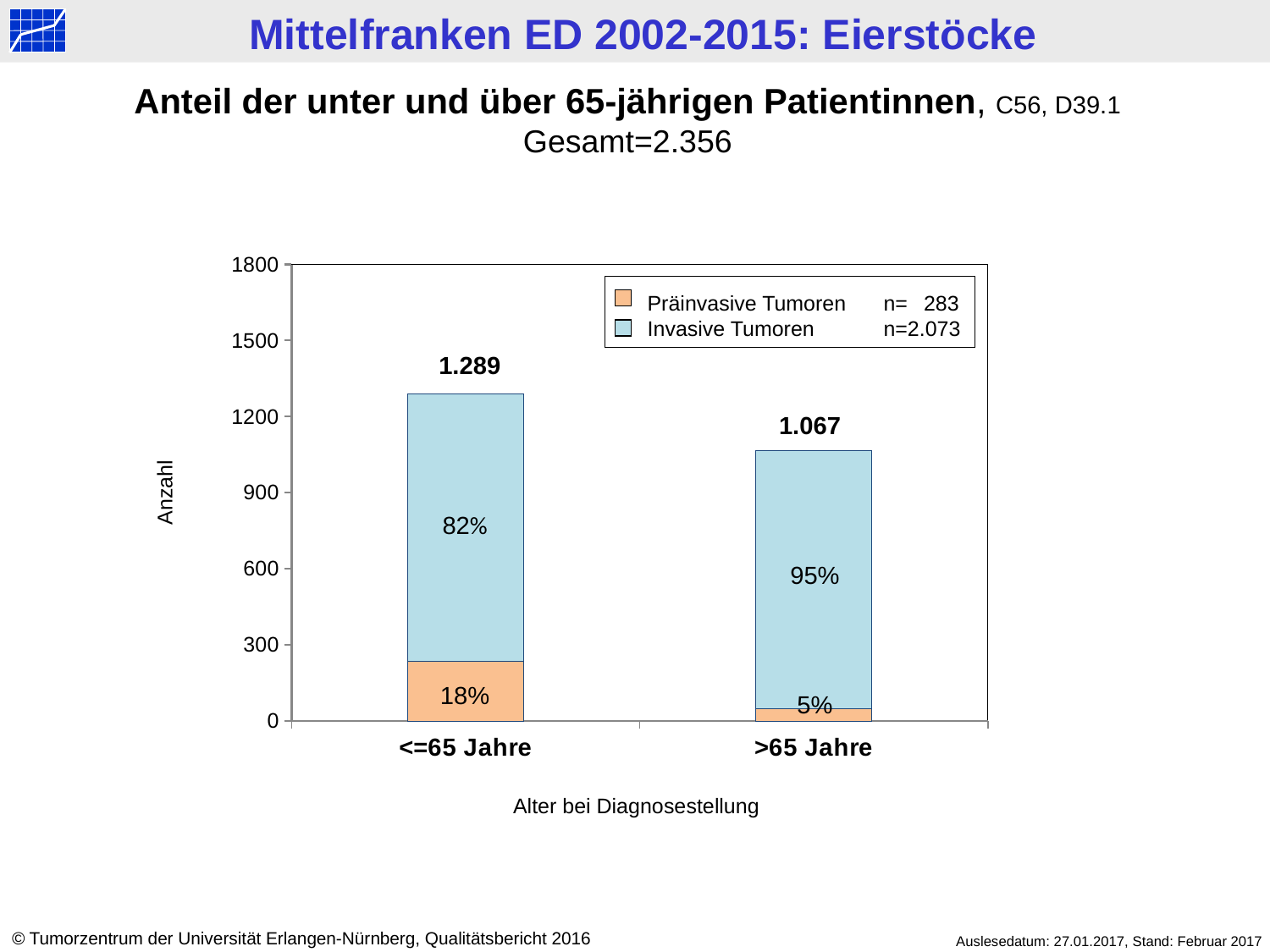
What kind of chart is shown on the slide? Stacked bar chart What is the total number of patients shown for the <=65 Jahre bar? 1.289 How many age categories are shown on the x axis? 2 Which age group has the higher total number of patients? <=65 Jahre What percentage of the <=65 Jahre bar is Präinvasive Tumoren? 18% According to the legend, what is the n for Invasive Tumoren? n=2.073 What is the total number of patients shown for the >65 Jahre bar? 1.067 What percentage of the >65 Jahre bar is Präinvasive Tumoren? 5% What percentage of the >65 Jahre bar is Invasive Tumoren? 95% What is the difference between the totals of the <=65 Jahre and >65 Jahre bars? 222 Is the total for the >65 Jahre bar greater or less than 1200? less How many series does the legend list? 2